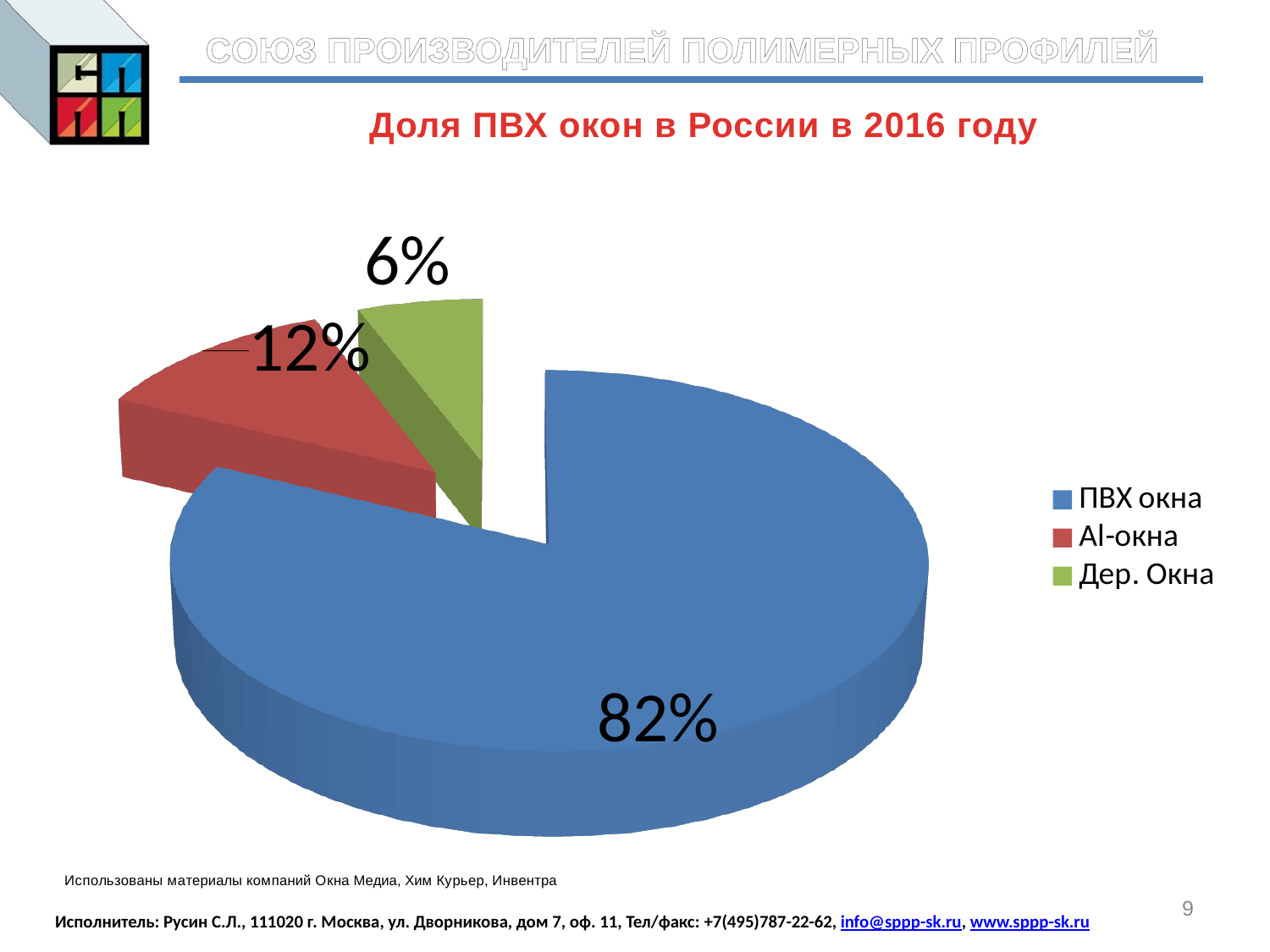
What share of the pie does Al-окна have? 12% What is the difference between the shares of ПВХ окна and Al-окна? 70% Which category has the smallest share of the pie? Дер. Окна What is the difference between the shares of Al-окна and Дер. Окна? 6% What kind of chart is shown on the slide? Pie chart What colour represents Al-окна in the legend? Red Which has a larger share, Al-окна or Дер. Окна? Al-окна How many categories are shown in the pie chart? 3 What share of the pie does ПВХ окна have? 82% What is the title of the chart? Доля ПВХ окон в России в 2016 году What share of the pie does Дер. Окна have? 6% Which category has the largest share of the pie? ПВХ окна